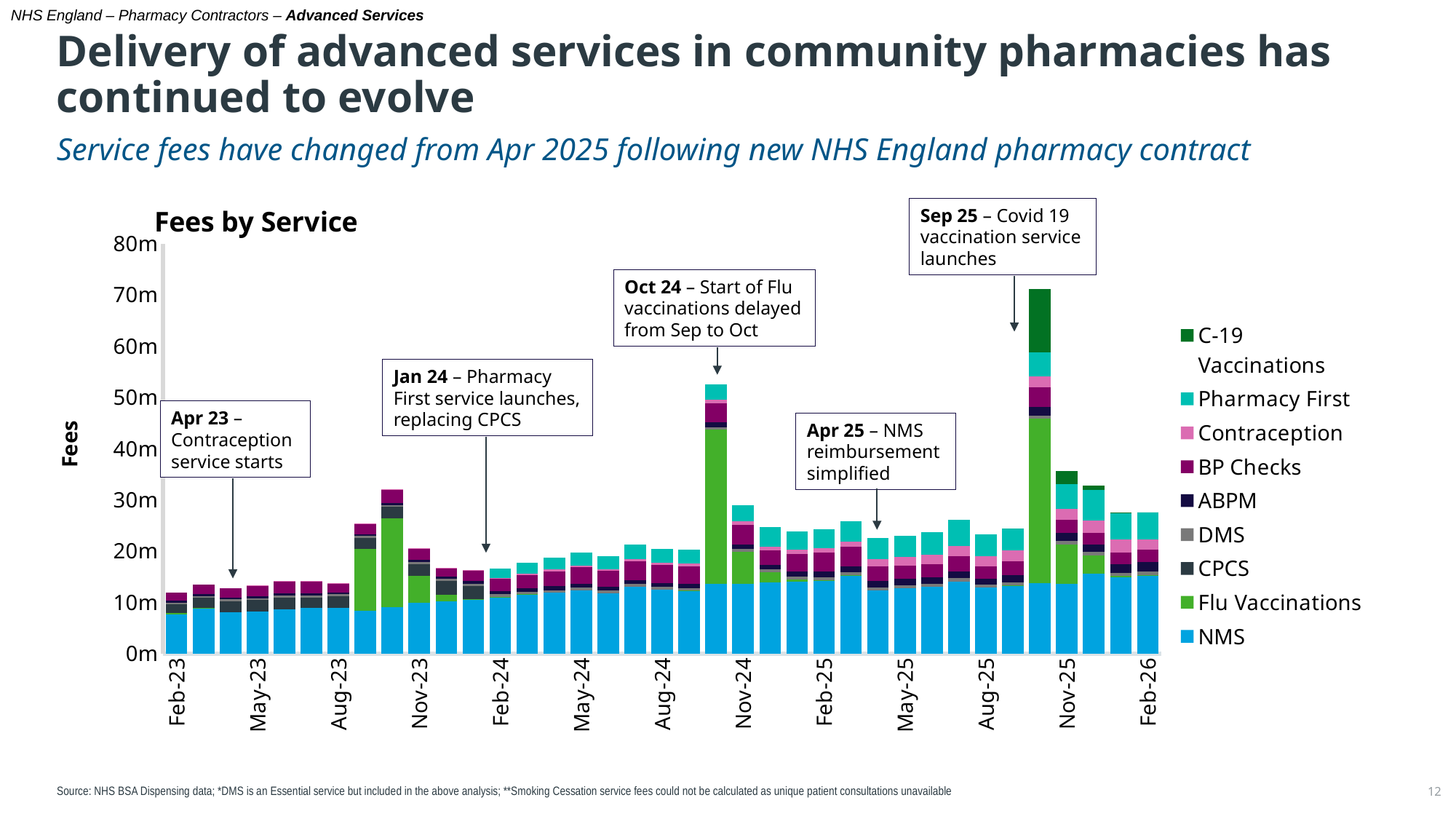
Does the NMS segment generally rise or fall from Feb-23 to Feb-26? rise Is the total fees value for Feb-23 greater or less than 20m? less How many monthly bars are plotted in the 'Fees by Service' chart? 37 How many series does the legend of the 'Fees by Service' chart list? 9 Is the total fees value for Oct-25 greater or less than 60m? greater Which month has the highest total fees in the 'Fees by Service' chart? Oct-25 Which month has the larger total fees, Feb-23 or Feb-26? Feb-26 Which month has the larger total fees, Oct-24 or Oct-25? Oct-25 Which series forms the bottom segment of each stacked bar in the 'Fees by Service' chart? NMS Is the total fees value for Feb-26 greater or less than 20m? greater What kind of chart is 'Fees by Service'? Stacked bar chart